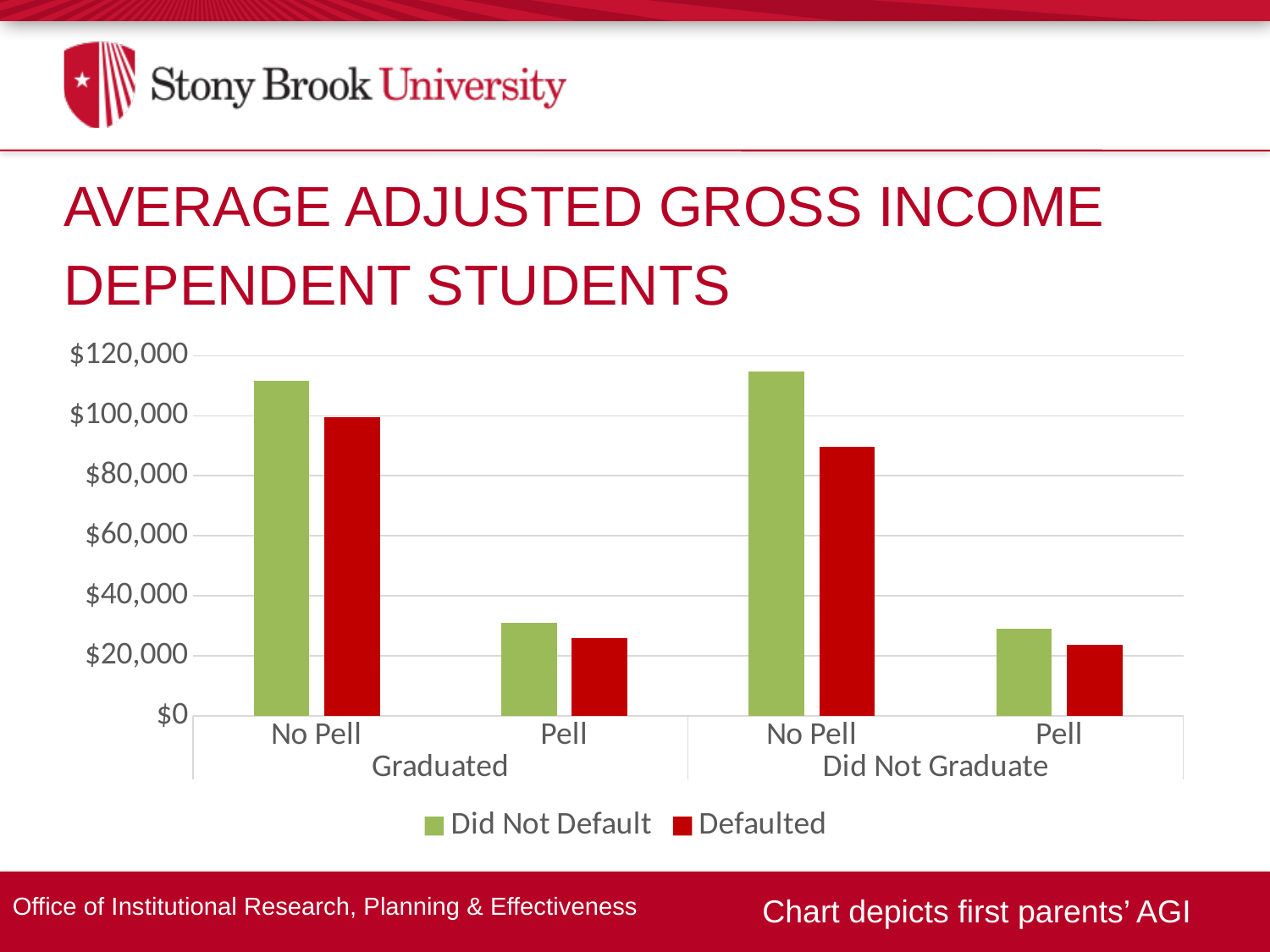
What kind of chart is shown on the slide? bar chart How many series does the legend list? 2 Among No Pell students who Did Not Graduate, which series has the larger value, Did Not Default or Defaulted? Did Not Default Among students who Graduated, which group has the larger Did Not Default value, No Pell or Pell? No Pell What are the two series named in the legend? Did Not Default and Defaulted How many bars are plotted in total on the chart? 8 Is the Defaulted value for Pell students who Did Not Graduate greater or less than $20,000? greater What colour are the bars for the Defaulted series? red Among Pell students who Graduated, which series has the larger value, Did Not Default or Defaulted? Did Not Default Is the Did Not Default value for No Pell students who Graduated greater or less than $100,000? greater Is the Defaulted value for No Pell students who Did Not Graduate greater or less than $100,000? less